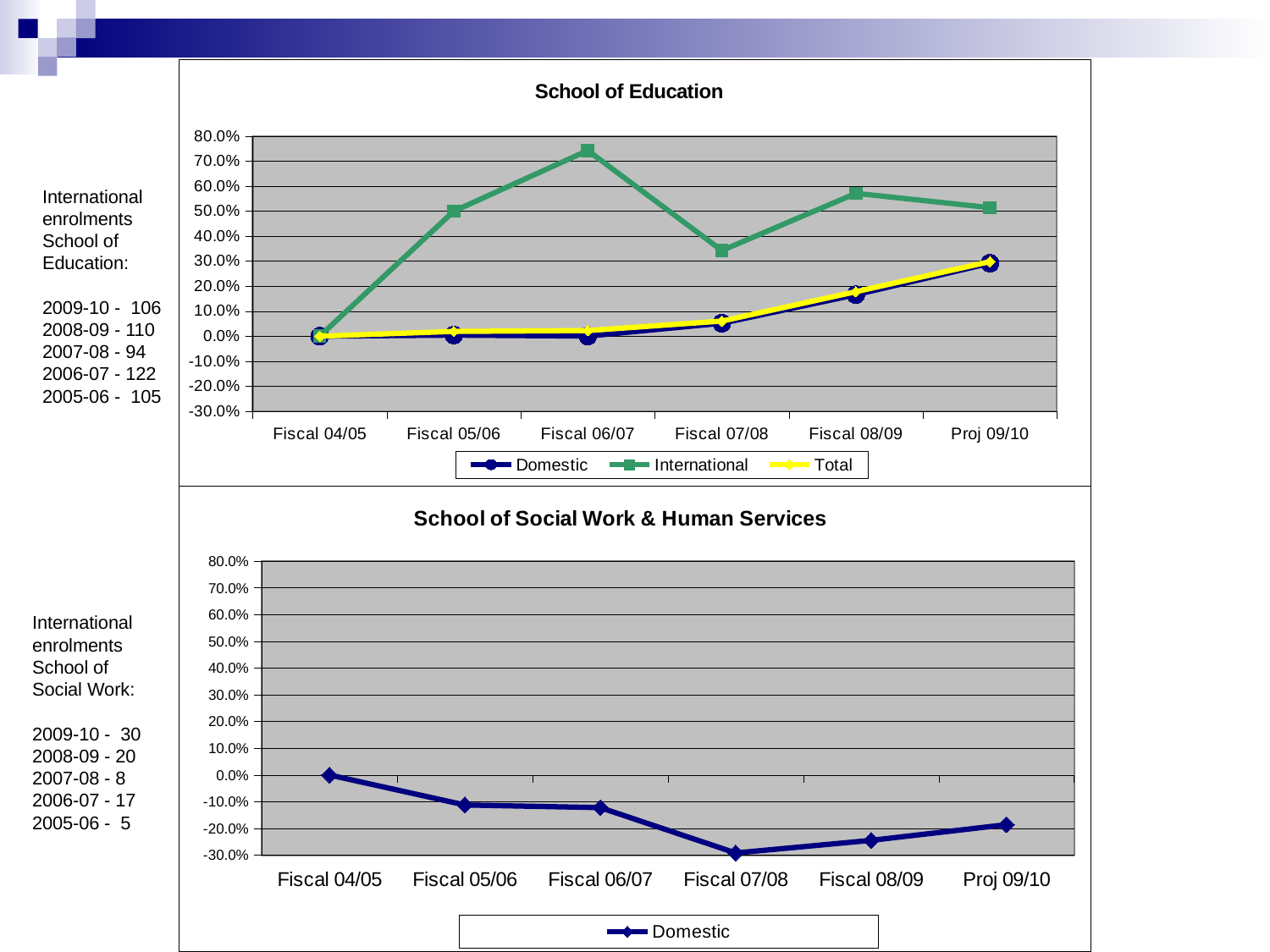
In the 'School of Education' chart, what is the Domestic value for Fiscal 04/05? 0.0% In the 'School of Education' chart, is the International value for Fiscal 06/07 greater or less than 70.0%? greater In the 'School of Education' chart, which is larger at Fiscal 08/09: the International value or the Domestic value? International How many series does the legend of the 'School of Education' chart list? 3 How many fiscal periods are shown on the x axis of the 'School of Education' chart? 6 What type of chart is the 'School of Education' chart? line chart In the 'School of Education' chart, is the International value for Fiscal 07/08 greater or less than 40.0%? less In the 'School of Social Work & Human Services' chart, in which fiscal period is the Domestic value lowest? Fiscal 07/08 In the 'School of Social Work & Human Services' chart, is the Domestic value for Fiscal 08/09 greater or less than -20.0%? less What is the title of the lower chart on the slide? School of Social Work & Human Services In the 'School of Education' chart, in which fiscal period does the International series reach its highest value? Fiscal 06/07 How many series does the legend of the 'School of Social Work & Human Services' chart list? 1